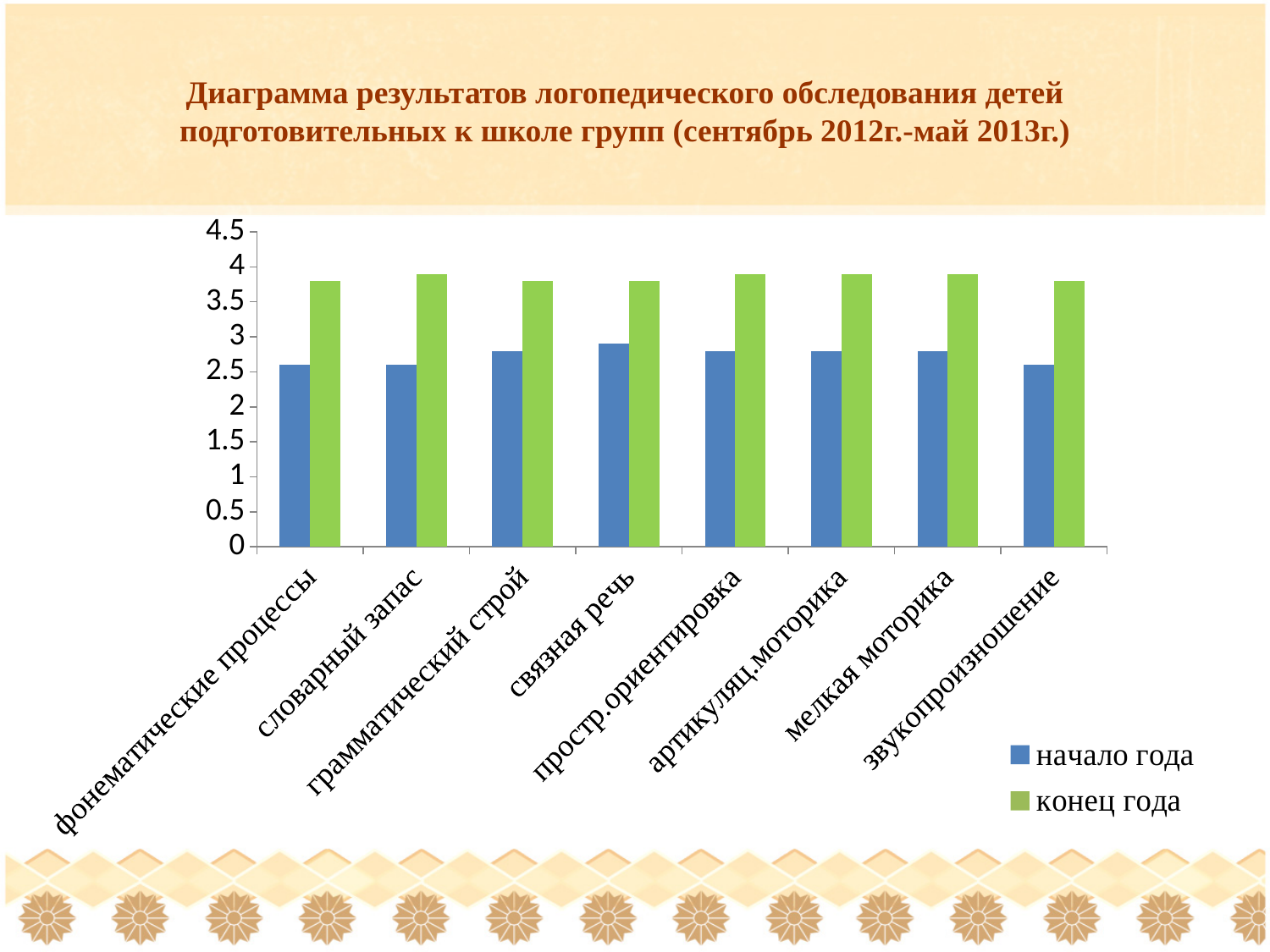
Is the value for "начало года" for "звукопроизношение" greater or less than 3? less Is the value for "конец года" for "мелкая моторика" greater or less than 4? less Is the value for "начало года" for "связная речь" greater or less than 2.5? greater How many categories are shown on the x axis of the chart? 8 Which series is shown in green in the chart? конец года What kind of chart is shown on the slide? bar chart What are the two legend entries of the chart? начало года, конец года For "артикуляц.моторика", which series has the larger value, "начало года" or "конец года"? конец года How many series does the legend list? 2 For "грамматический строй", which series has the larger value, "начало года" or "конец года"? конец года